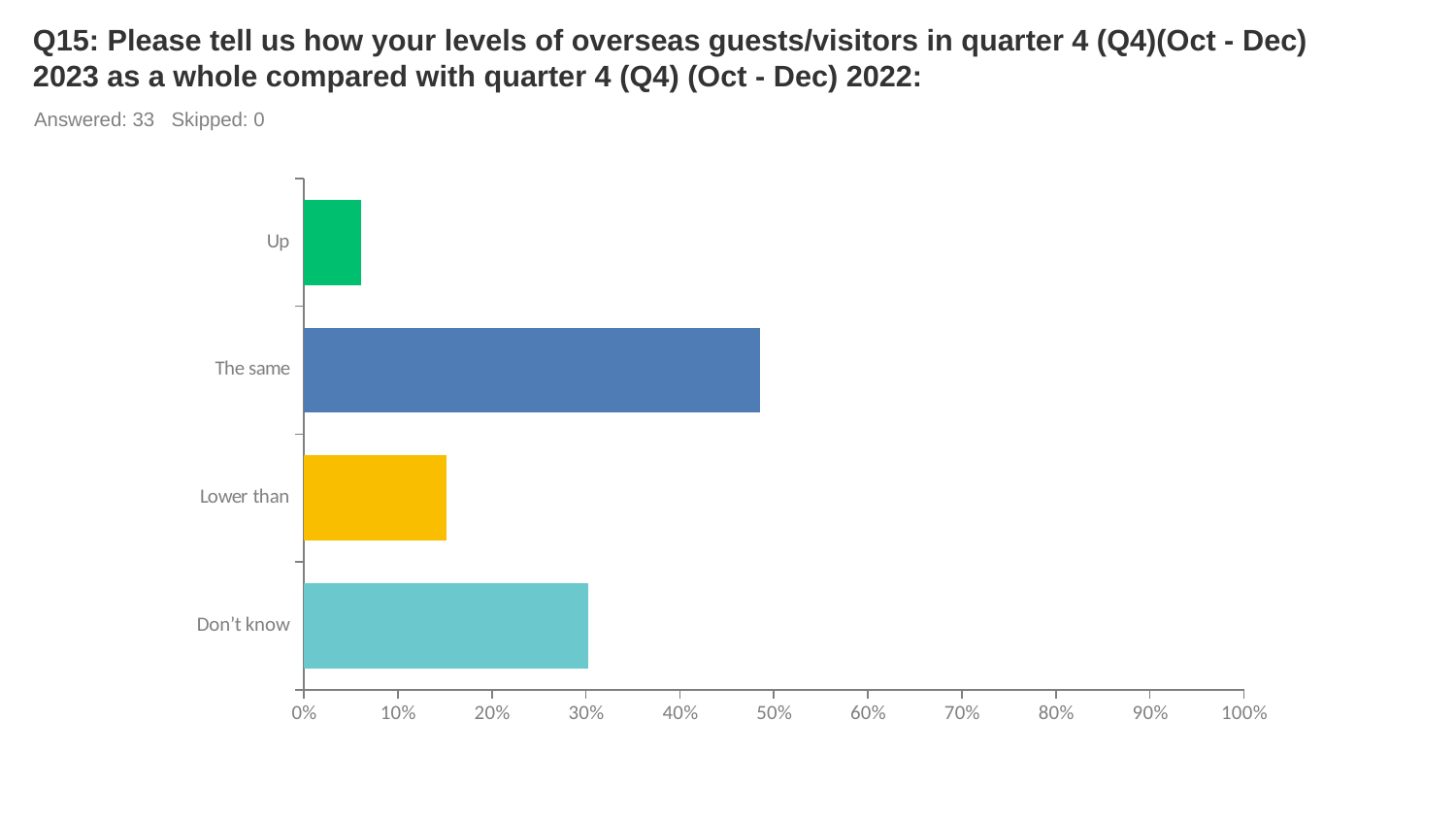
How many categories are plotted in the chart? 4 Is the value for 'The same' greater or less than 40%? greater What kind of chart is shown on the slide? bar chart How many respondents answered this question, according to the slide? 33 Which category has the lowest value? Up Which is larger, the value for 'Don't know' or the value for 'Lower than'? Don't know Which category has the highest value? The same Is the value for 'Don't know' greater or less than 20%? greater Is the value for 'Up' greater or less than 10%? less Which is larger, the value for 'Up' or the value for 'Lower than'? Lower than What is the maximum value shown on the horizontal axis? 100%